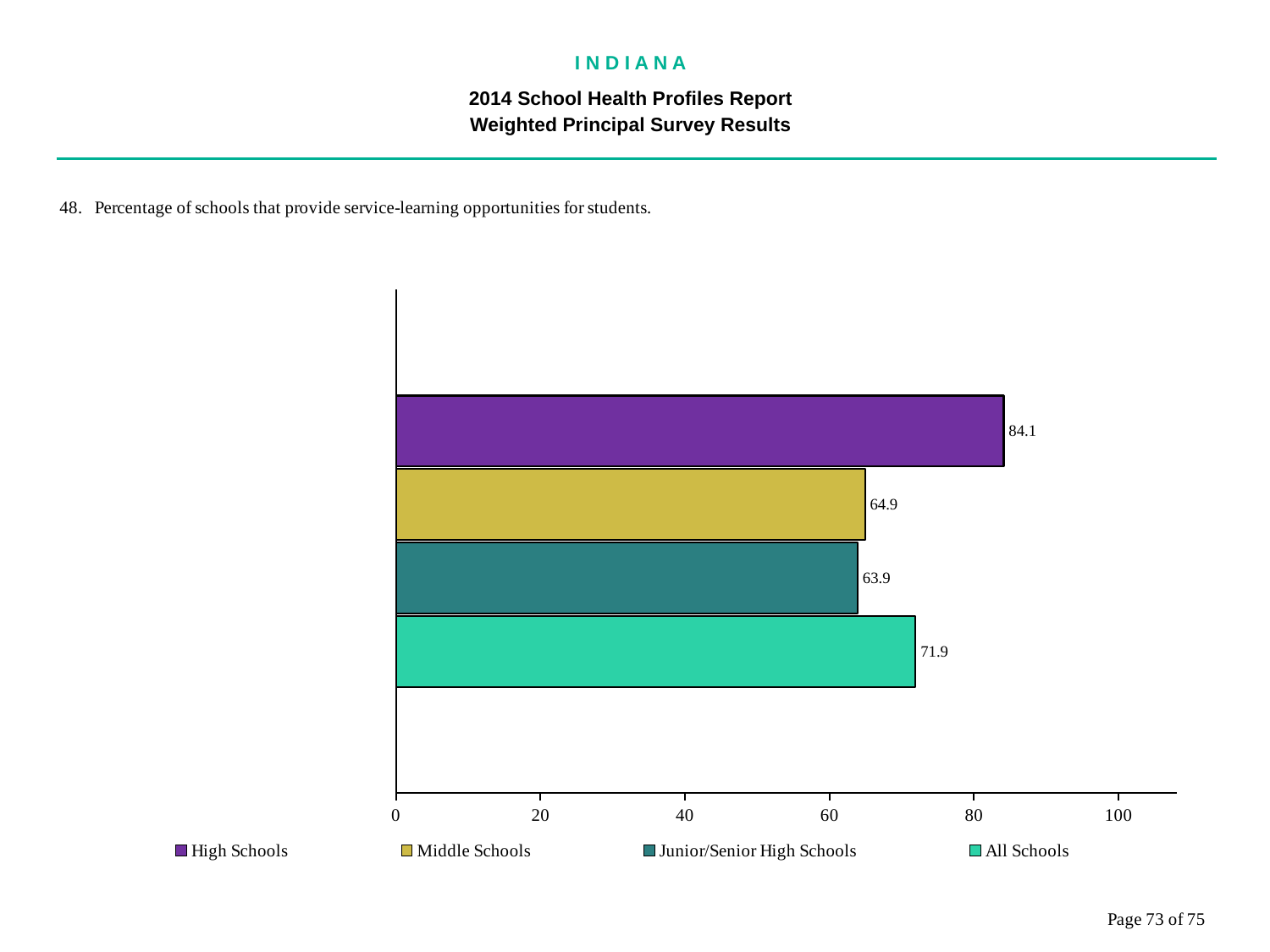
Is the value for High Schools greater or less than 80? greater What is the value for Junior/Senior High Schools? 63.9 Which school type has the highest percentage? High Schools Which school type has the lowest percentage? Junior/Senior High Schools What is the value for Middle Schools? 64.9 How many series does the legend list? 4 What is the difference between the Middle Schools value and the Junior/Senior High Schools value? 1.0 What is the value for High Schools? 84.1 What is the value for All Schools? 71.9 What kind of chart is shown on the slide? bar chart What is the difference between the High Schools value and the All Schools value? 12.2 Which is larger, the value for All Schools or the value for Middle Schools? All Schools